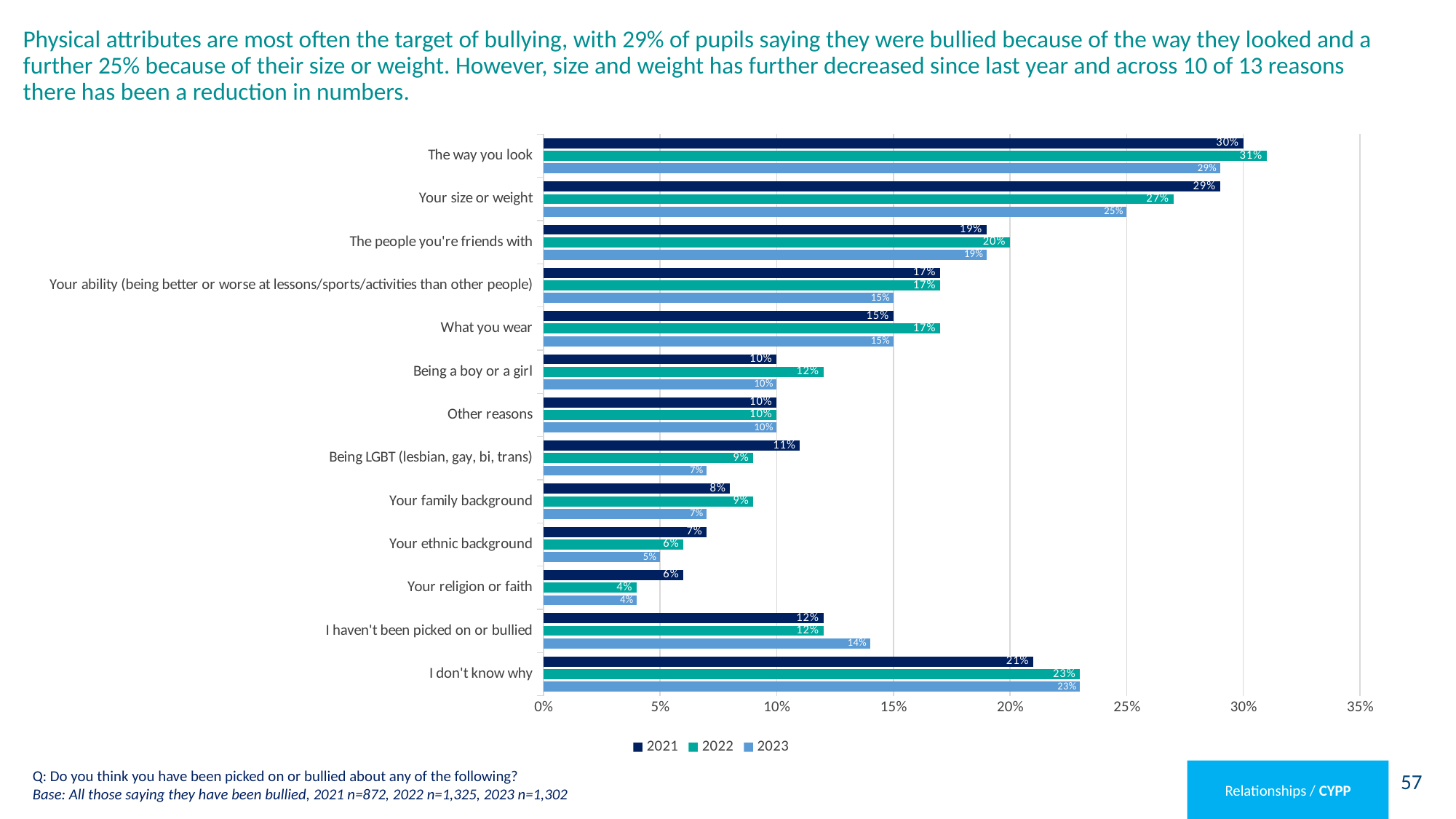
What is the 2021 value for 'I don't know why'? 21% Which is larger for 'I haven't been picked on or bullied': the 2021 value or the 2023 value? 2023 What kind of chart is shown on the slide? Bar chart Which category has the highest 2023 value? The way you look What is the 2023 value for 'Your size or weight'? 25% How many series does the legend list? 3 What is the 2022 value for 'The way you look'? 31% Which category has the lowest 2022 value? Your religion or faith Is the 2021 value for 'The people you're friends with' greater or less than 15%? greater What is the difference between the 2022 and 2023 values for 'Your size or weight'? 2% Which years are listed in the chart legend? 2021, 2022, 2023 How many categories are shown on the chart? 13